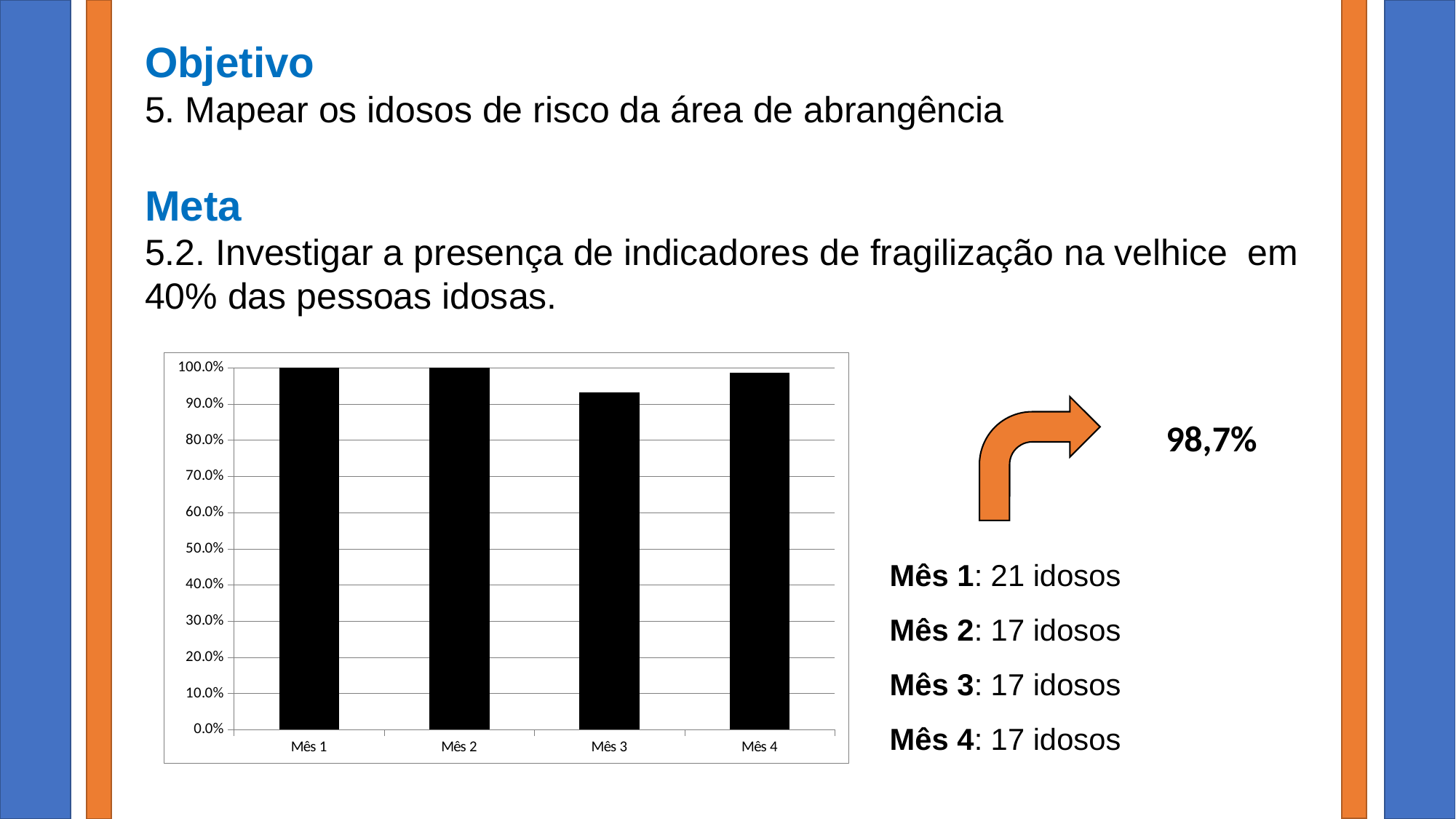
Is the value for Mês 3 greater or less than 90.0%? greater What is the value for Mês 1? 100.0% Is the value for Mês 4 greater or less than 90.0%? greater How many categories are shown on the x axis? 4 Which category has the lowest value? Mês 3 What is the highest value shown on the y axis? 100.0% What colour are the bars in the chart? black Which is larger, the value for Mês 3 or the value for Mês 4? Mês 4 What is the value for Mês 2? 100.0% Is the value for Mês 3 greater or less than 100.0%? less Which is larger, the value for Mês 1 or the value for Mês 3? Mês 1 What kind of chart is shown on the slide? bar chart